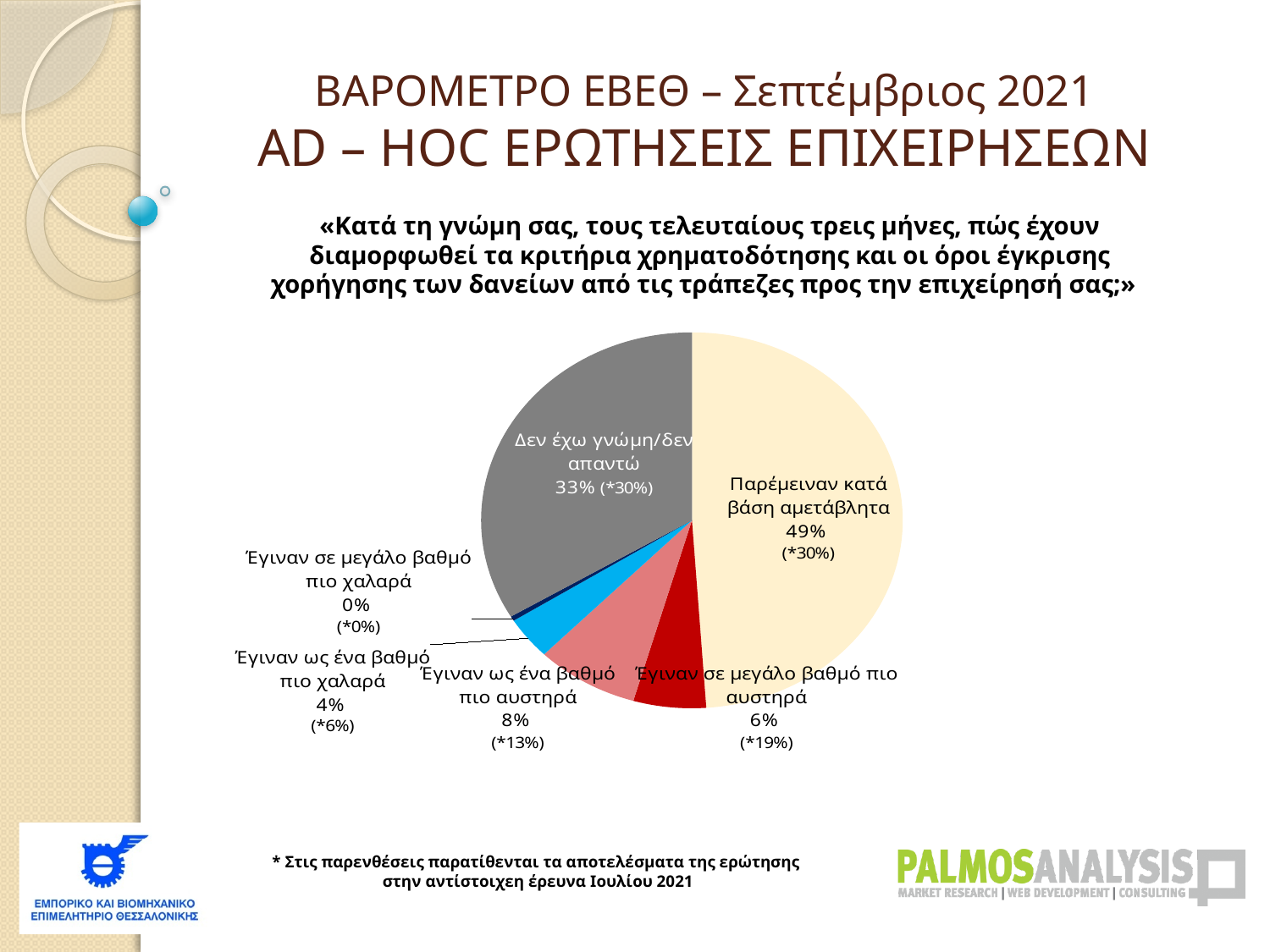
Which is larger: the share for "Έγιναν ως ένα βαθμό πιο αυστηρά" or for "Έγιναν ως ένα βαθμό πιο χαλαρά"? Έγιναν ως ένα βαθμό πιο αυστηρά What percentage of respondents answered "Έγιναν ως ένα βαθμό πιο αυστηρά"? 8% Which response category has the smallest share of the pie? Έγιναν σε μεγάλο βαθμό πιο χαλαρά How many response categories are shown in the pie chart? 6 Which response category has the largest share of the pie? Παρέμειναν κατά βάση αμετάβλητα What percentage of respondents answered "Έγιναν σε μεγάλο βαθμό πιο αυστηρά"? 6% What was the July 2021 result (shown in parentheses) for "Έγιναν σε μεγάλο βαθμό πιο αυστηρά"? 19% What is the difference in percentage points between "Παρέμειναν κατά βάση αμετάβλητα" and "Δεν έχω γνώμη/δεν απαντώ"? 16 What percentage of respondents answered "Δεν έχω γνώμη/δεν απαντώ"? 33% What percentage of respondents answered "Παρέμειναν κατά βάση αμετάβλητα"? 49% According to the footnote, which survey do the values in parentheses refer to? Ιουλίου 2021 What type of chart is shown on the slide? pie chart